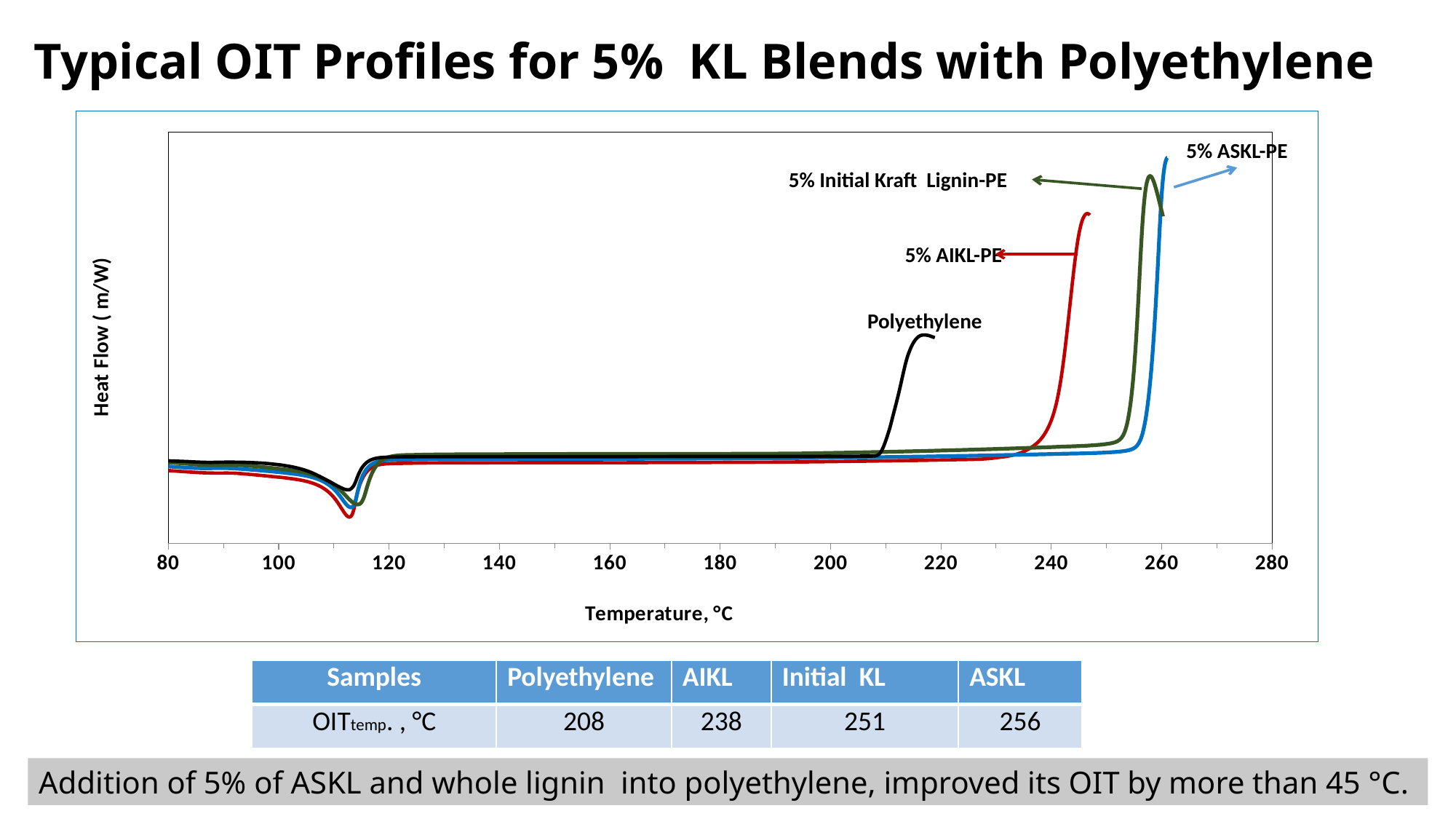
What is the label of the x axis of the chart? Temperature, °C According to the table below the chart, what is the OIT temperature for AIKL? 238 What is the difference in OIT temperature between ASKL and Polyethylene in the table? 48 Is the temperature at which the Polyethylene curve rises sharply greater or less than 220? less According to the table below the chart, what is the OIT temperature for Polyethylene? 208 Which sample in the table has the highest OIT temperature? ASKL How many curves are plotted on the chart? 4 What is the label of the y axis of the chart? Heat Flow ( m/W) What kind of chart is shown on the slide? Line chart According to the table below the chart, what is the OIT temperature for ASKL? 256 Which curve rises sharply at a higher temperature: 5% AIKL-PE or 5% ASKL-PE? 5% ASKL-PE Which sample in the table has the lowest OIT temperature? Polyethylene